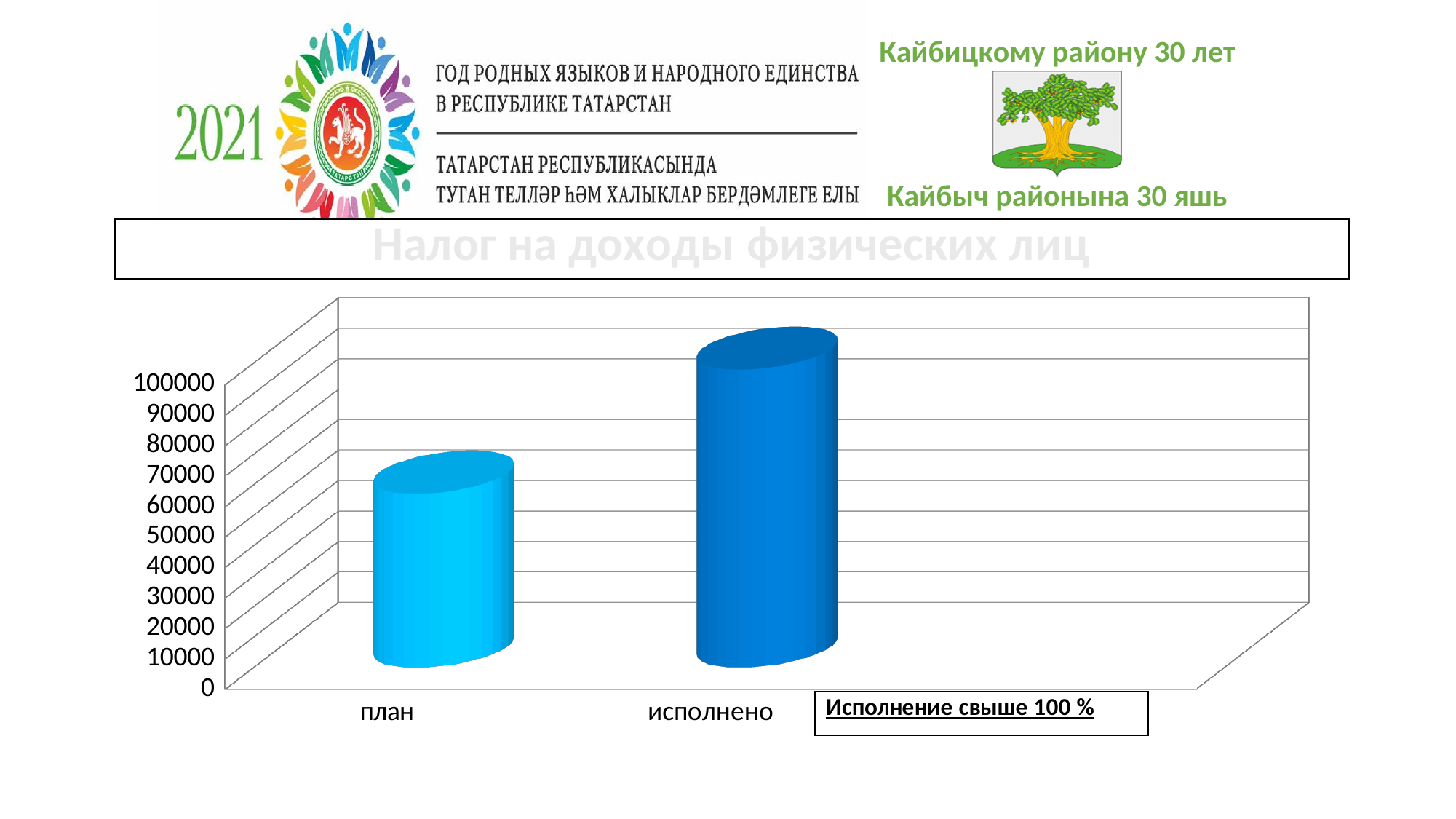
What is the title of the chart on the slide? Налог на доходы физических лиц What kind of chart is shown on the slide? bar chart Which category has the highest bar in the chart? исполнено Which category has the lowest bar in the chart? план Is the value for исполнено greater or less than 50000? greater Is the value for план greater or less than 90000? less Which is larger, the value for план or the value for исполнено? исполнено What does the text box next to the chart's x axis say? Исполнение свыше 100 % How many categories are shown on the x axis of the chart? 2 Do the bar values rise or fall from план to исполнено? rise What is the highest value labelled on the chart's vertical axis? 100000 Is the value for план greater or less than 30000? greater